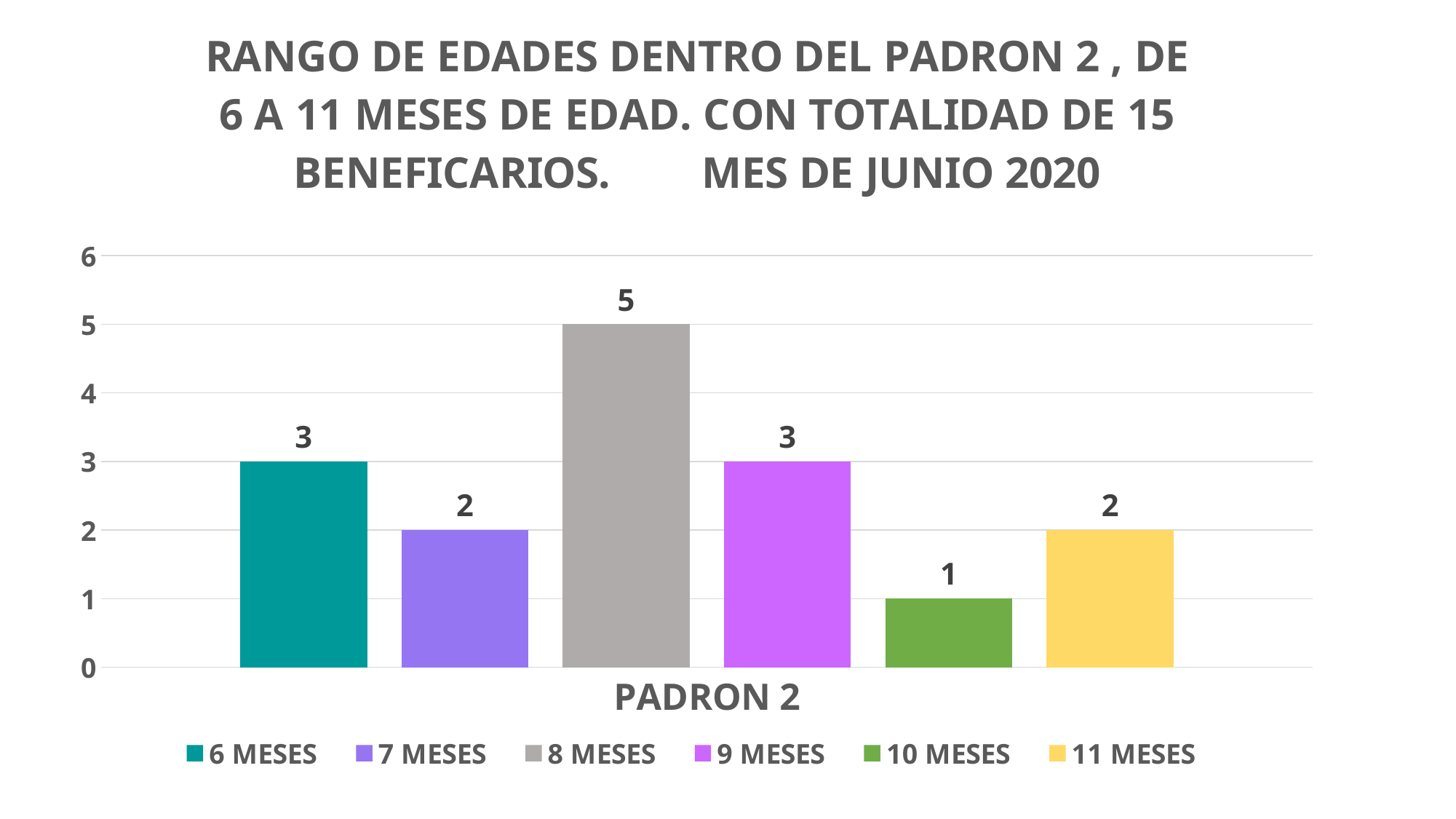
Which series has the highest value? 8 MESES Which is larger, the value for 9 MESES or the value for 11 MESES? 9 MESES What is the total of all the bars shown? 15 What is the value for 8 MESES? 5 How many series does the legend list? 6 What kind of chart is shown? bar chart Is the value for 8 MESES greater or less than 4? greater What is the category label shown on the x axis? PADRON 2 What is the difference between the values for 8 MESES and 7 MESES? 3 What is the value for 10 MESES? 1 What is the value for 6 MESES? 3 Which series has the lowest value? 10 MESES